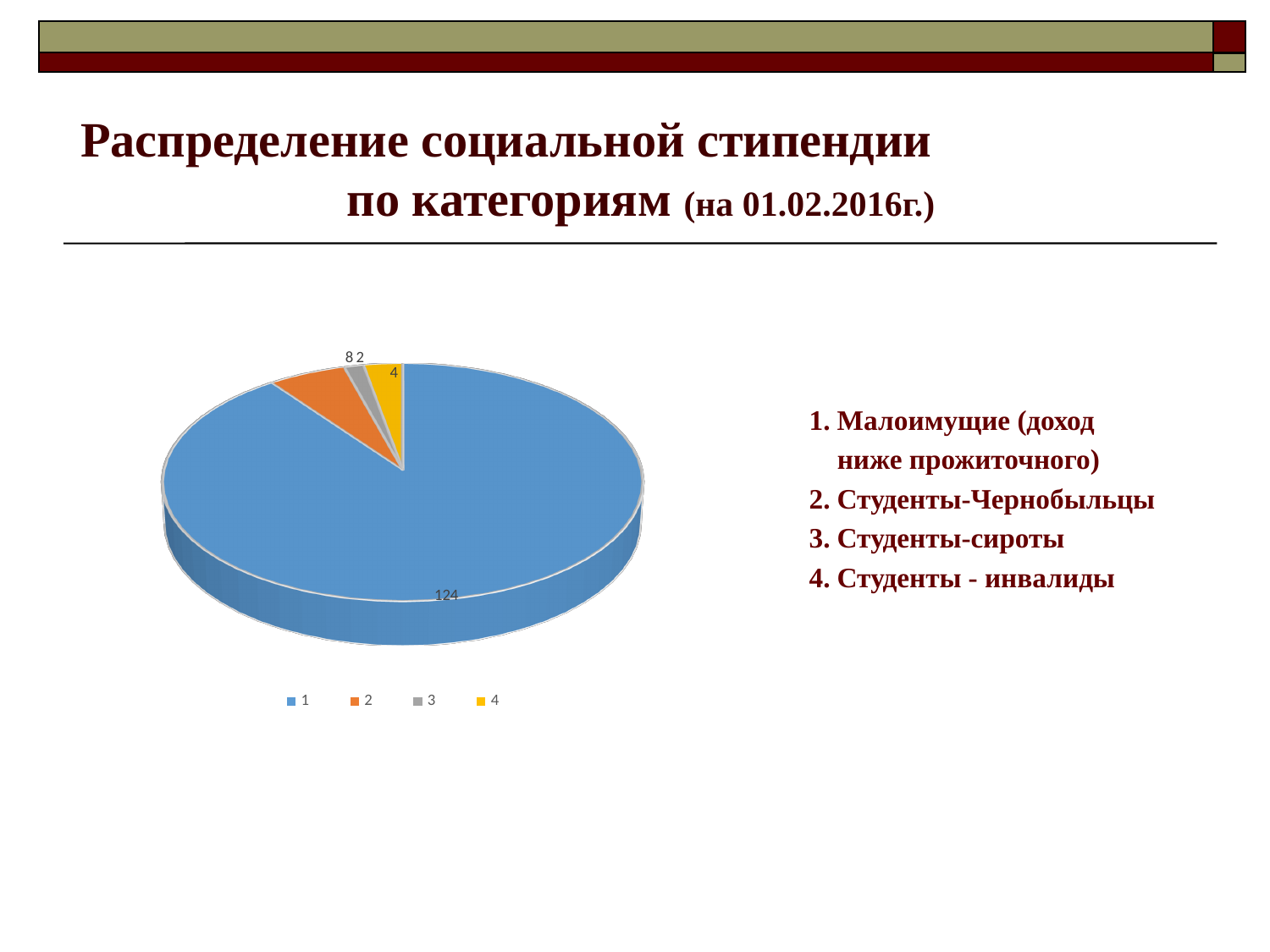
What is the total of all the values in the pie chart? 138 Which is larger, the value for category 2 or the value for category 4? 2 What type of chart is shown on the slide? pie chart What colour is the slice for category 2 in the pie chart? orange What is the value for category 4 in the pie chart? 4 How many slices does the pie chart have? 4 What is the value for category 3 in the pie chart? 2 What is the difference between the values for category 1 and category 2? 116 What is the value for category 2 in the pie chart? 8 Which category has the smallest slice in the pie chart? 3 Which category has the largest slice in the pie chart? 1 What is the value for category 1 in the pie chart? 124